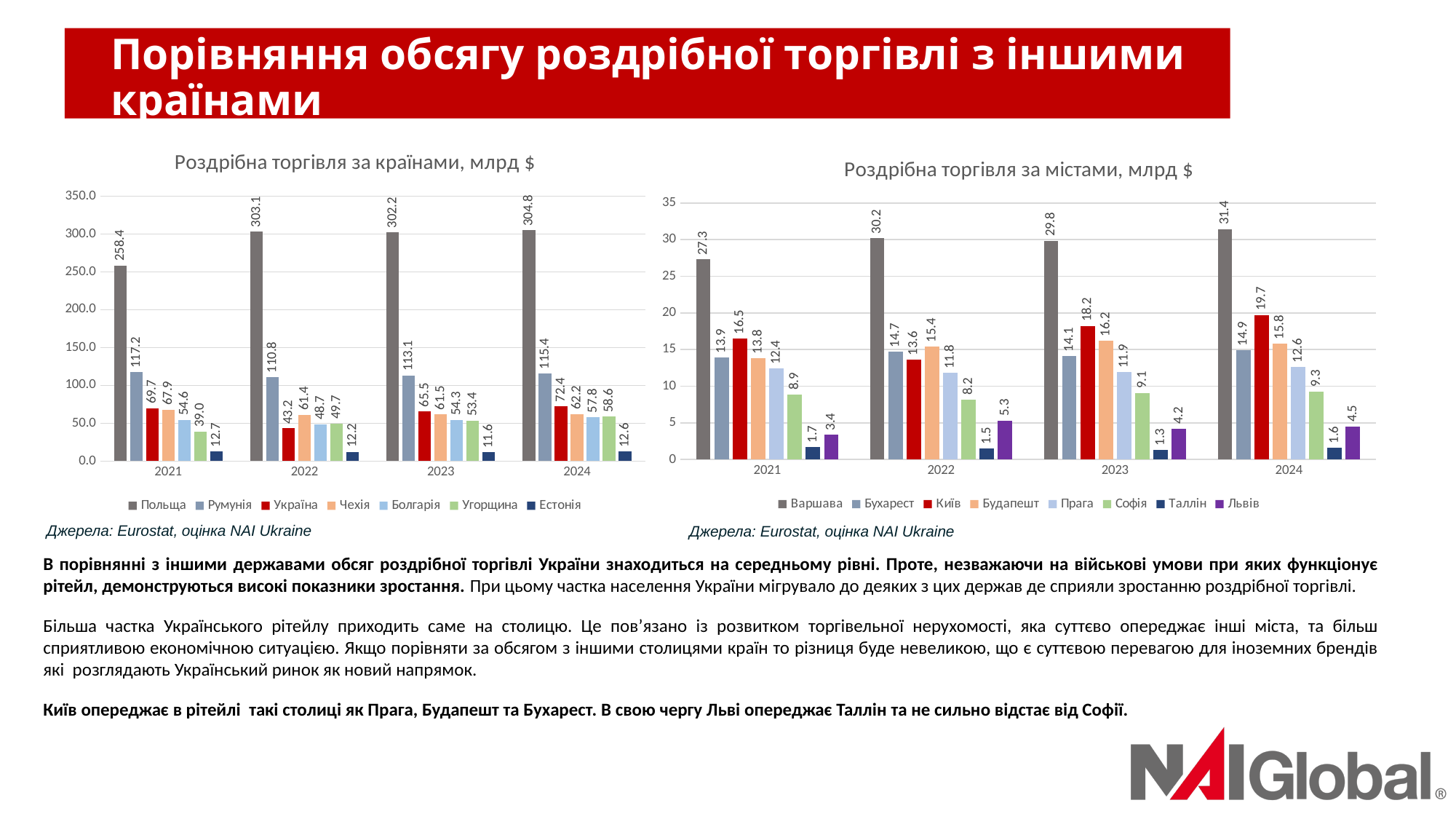
In the chart 'Роздрібна торгівля за містами, млрд $', what is the value for Київ in 2024? 19.7 What type of chart is the chart on the right of the slide? bar chart In the chart 'Роздрібна торгівля за країнами, млрд $', what is the difference between Польща and Румунія in 2024? 189.4 In the chart 'Роздрібна торгівля за містами, млрд $', which is larger in 2022: Київ or Будапешт? Будапешт In the chart 'Роздрібна торгівля за містами, млрд $', what is the difference between Львів and Таллін in 2021? 1.7 In the chart 'Роздрібна торгівля за містами, млрд $', which city has the highest value in 2023? Варшава In the chart 'Роздрібна торгівля за містами, млрд $', how many years are shown on the x axis? 4 In the chart 'Роздрібна торгівля за країнами, млрд $', how many series does the legend list? 7 In the chart 'Роздрібна торгівля за країнами, млрд $', which country has the lowest value in 2024? Естонія In the chart 'Роздрібна торгівля за країнами, млрд $', what is the value for Польща in 2021? 258.4 In the chart 'Роздрібна торгівля за країнами, млрд $', does the value for Україна rise or fall from 2022 to 2024? rise In the chart 'Роздрібна торгівля за країнами, млрд $', what is the value for Україна in 2022? 43.2